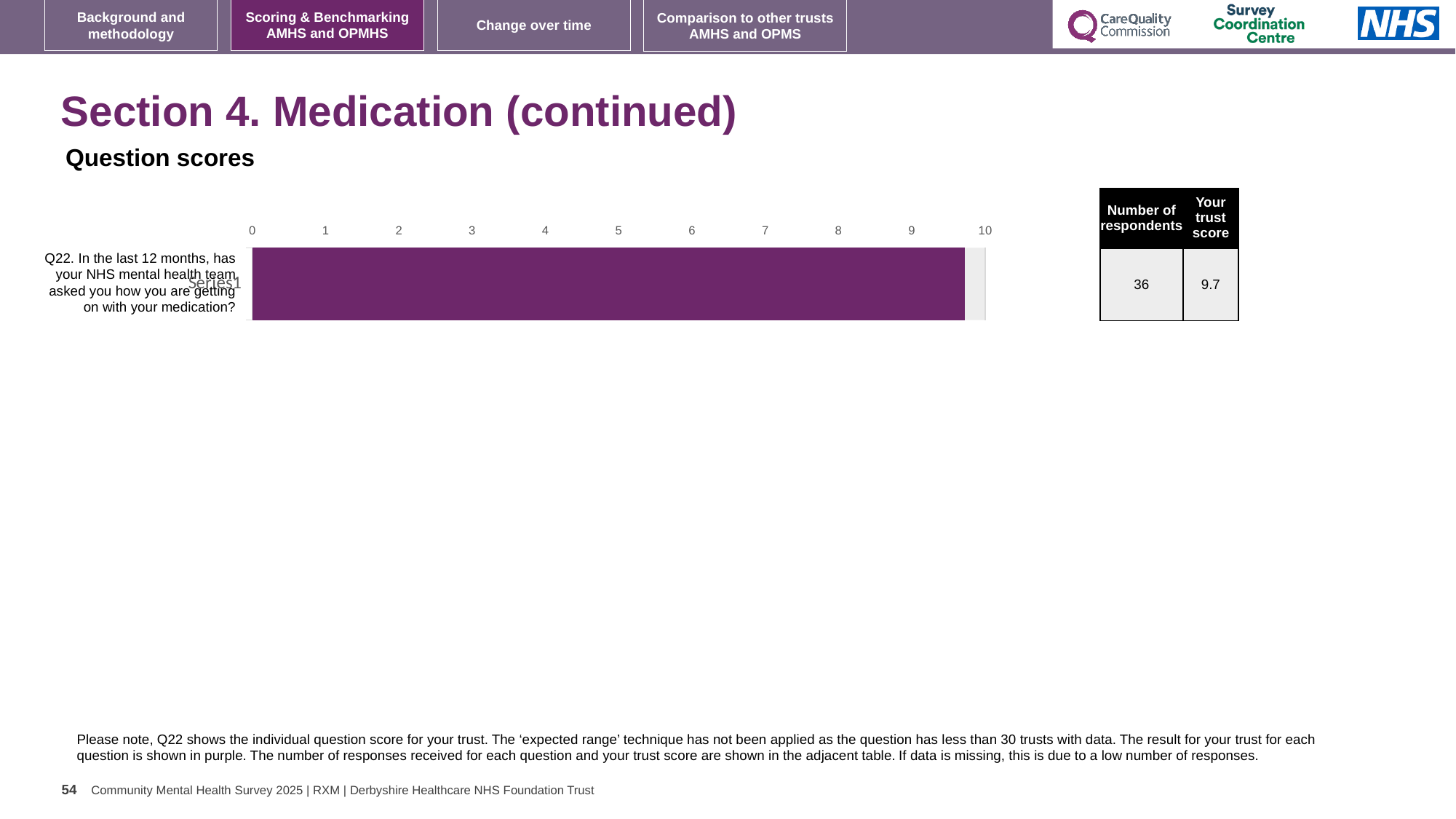
Is the value of the bar for Q22 greater or less than 9? greater What is the trust score for Q22 shown in the adjacent table? 9.7 Is the value of the bar for Q22 greater or less than 5? greater How many questions (categories) are plotted in the chart? 1 What is the maximum value shown on the chart's horizontal axis? 10 How many respondents are listed in the table for Q22? 36 What colour is the bar for Q22? purple What kind of chart is shown on the slide? bar chart